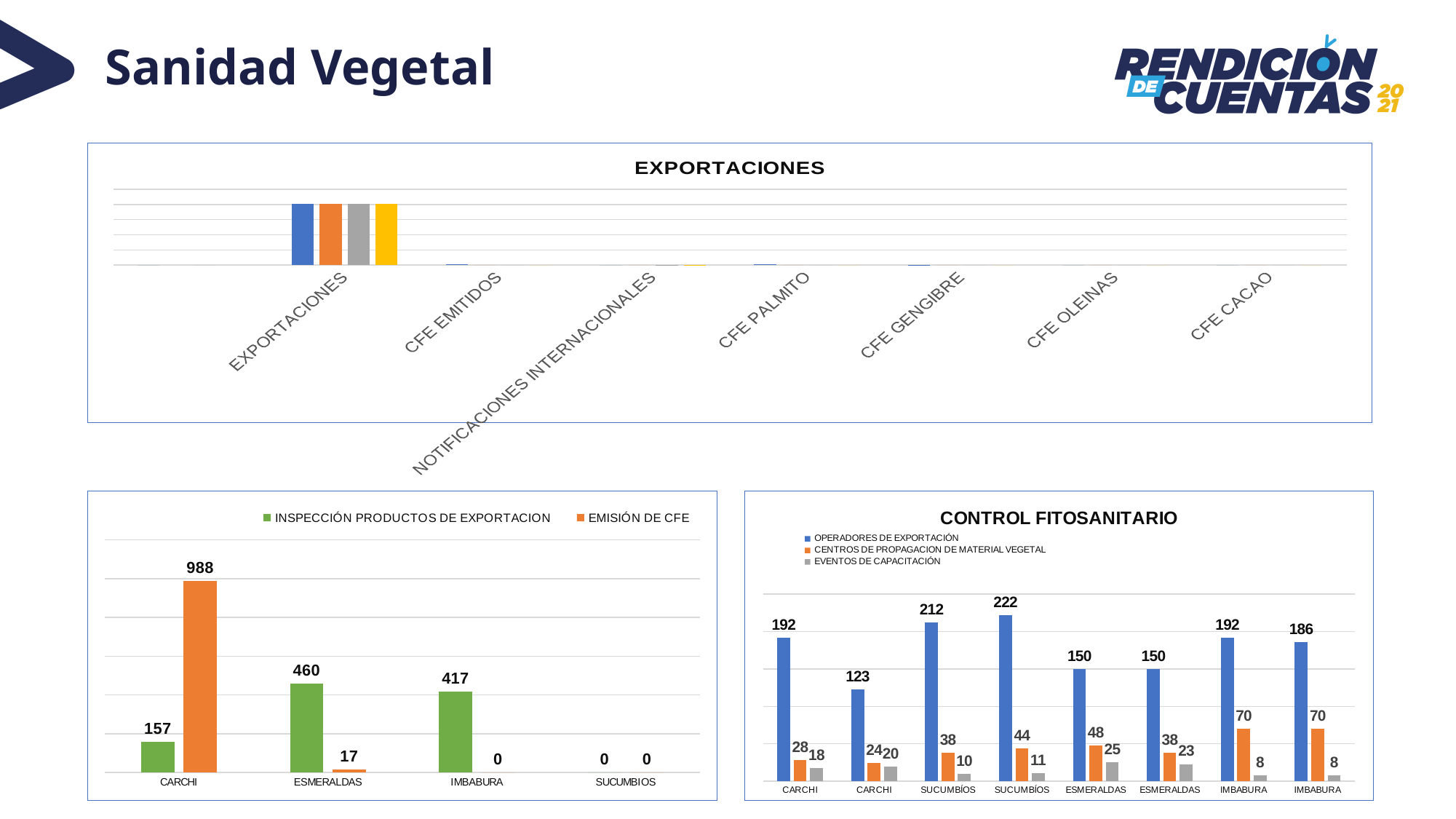
In the bottom-left chart, which category has the highest INSPECCIÓN PRODUCTOS DE EXPORTACION value? ESMERALDAS In the CONTROL FITOSANITARIO chart, what is the difference between the two OPERADORES DE EXPORTACIÓN values for the two SUCUMBÍOS groups? 10 In the CONTROL FITOSANITARIO chart, how many category groups are shown on the x axis? 8 In the bottom-left chart, how many series does the legend list? 2 In the bottom-left chart, what is the difference between EMISIÓN DE CFE and INSPECCIÓN PRODUCTOS DE EXPORTACION for CARCHI? 831 In the CONTROL FITOSANITARIO chart, how many series does the legend list? 3 How many categories are shown on the x axis of the EXPORTACIONES chart? 7 In the bottom-left chart, which is larger for IMBABURA: INSPECCIÓN PRODUCTOS DE EXPORTACION or EMISIÓN DE CFE? INSPECCIÓN PRODUCTOS DE EXPORTACION In the CONTROL FITOSANITARIO chart, what is the highest value of OPERADORES DE EXPORTACIÓN? 222 In the bottom-left chart, what is the value of EMISIÓN DE CFE for CARCHI? 988 In the CONTROL FITOSANITARIO chart, what is the lowest value of OPERADORES DE EXPORTACIÓN? 123 In the bottom-left chart, what is the value of INSPECCIÓN PRODUCTOS DE EXPORTACION for ESMERALDAS? 460